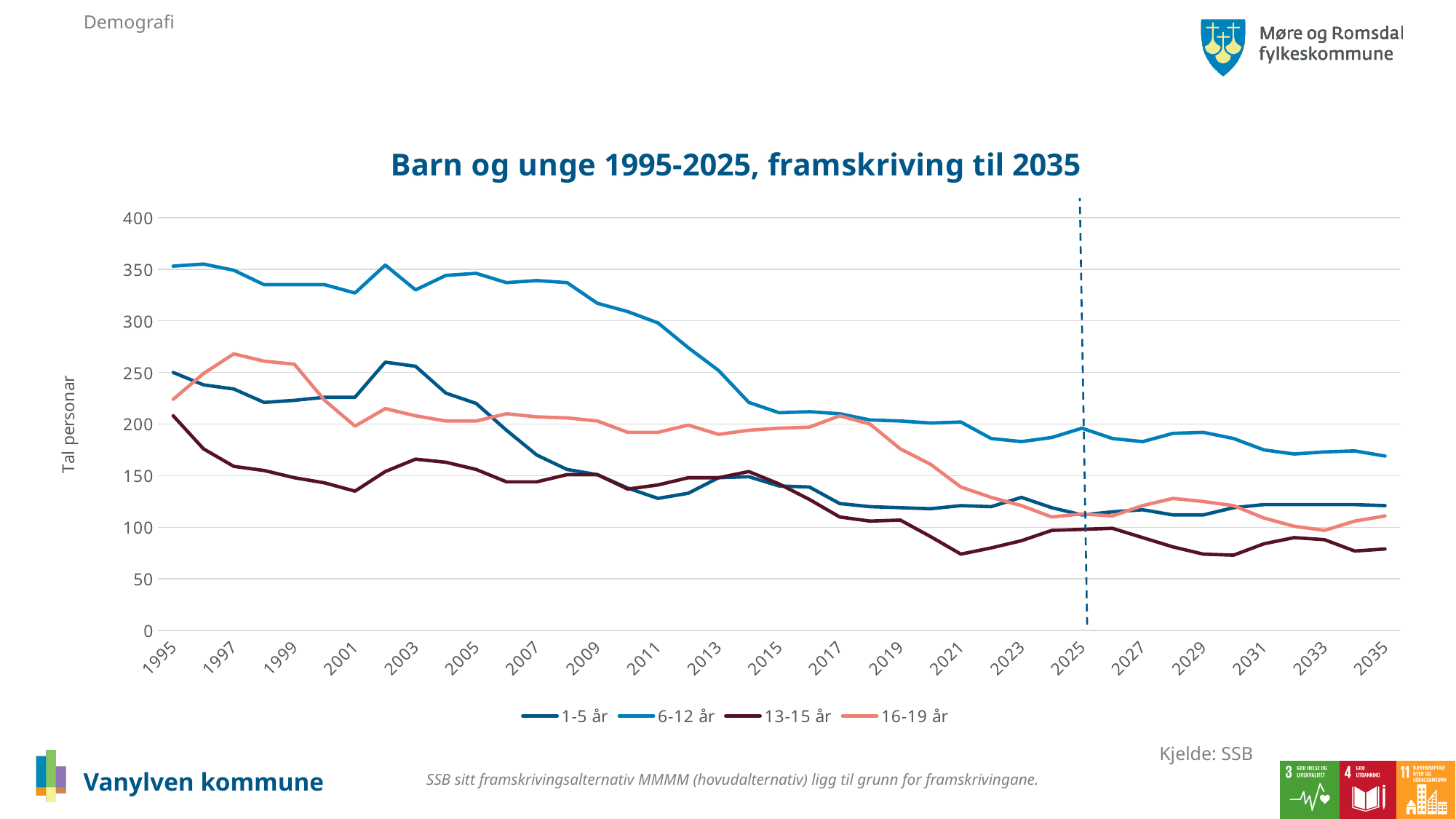
What is the title of the chart? Barn og unge 1995-2025, framskriving til 2035 Does the 6-12 år series rise or fall overall from 1995 to 2035? fall Which series has the lowest value in 2035? 13-15 år Which series has the highest value in 2005? 6-12 år Is the value for 13-15 år in 2021 greater or less than 100? less In 1997, which is larger: the value for 16-19 år or the value for 1-5 år? 16-19 år How many series does the legend list? 4 What kind of chart is shown on the slide? line chart What are the series names listed in the legend? 1-5 år, 6-12 år, 13-15 år, 16-19 år Is the value for 16-19 år in 2033 greater or less than 150? less Is the value for 1-5 år in 2003 greater or less than 200? greater